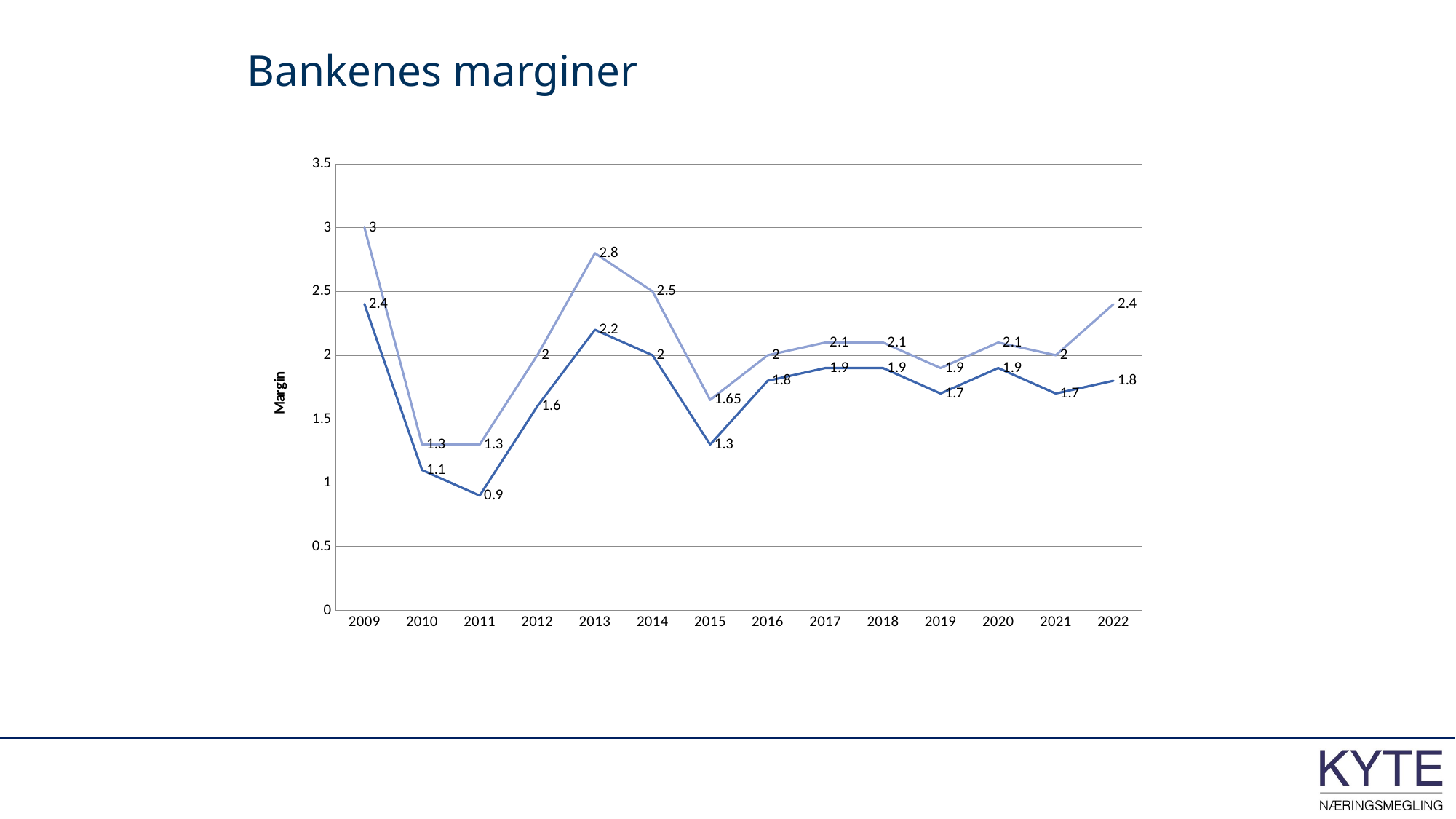
What kind of chart is shown on the slide? line chart What is the title of the chart? Bankenes marginer What is the difference between the light blue and dark blue lines in 2013? 0.6 What is the value of the light blue line in 2015? 1.65 In which year does the dark blue line reach its lowest value? 2011 Which line has the higher value in 2022, the light blue or the dark blue? light blue What is the value of the dark blue line in 2011? 0.9 How many years are shown along the x axis? 14 What is the value of the light blue line in 2009? 3 Does the dark blue line rise or fall from 2009 to 2011? fall In which year does the light blue line reach its highest value? 2009 What is the label on the vertical axis? Margin